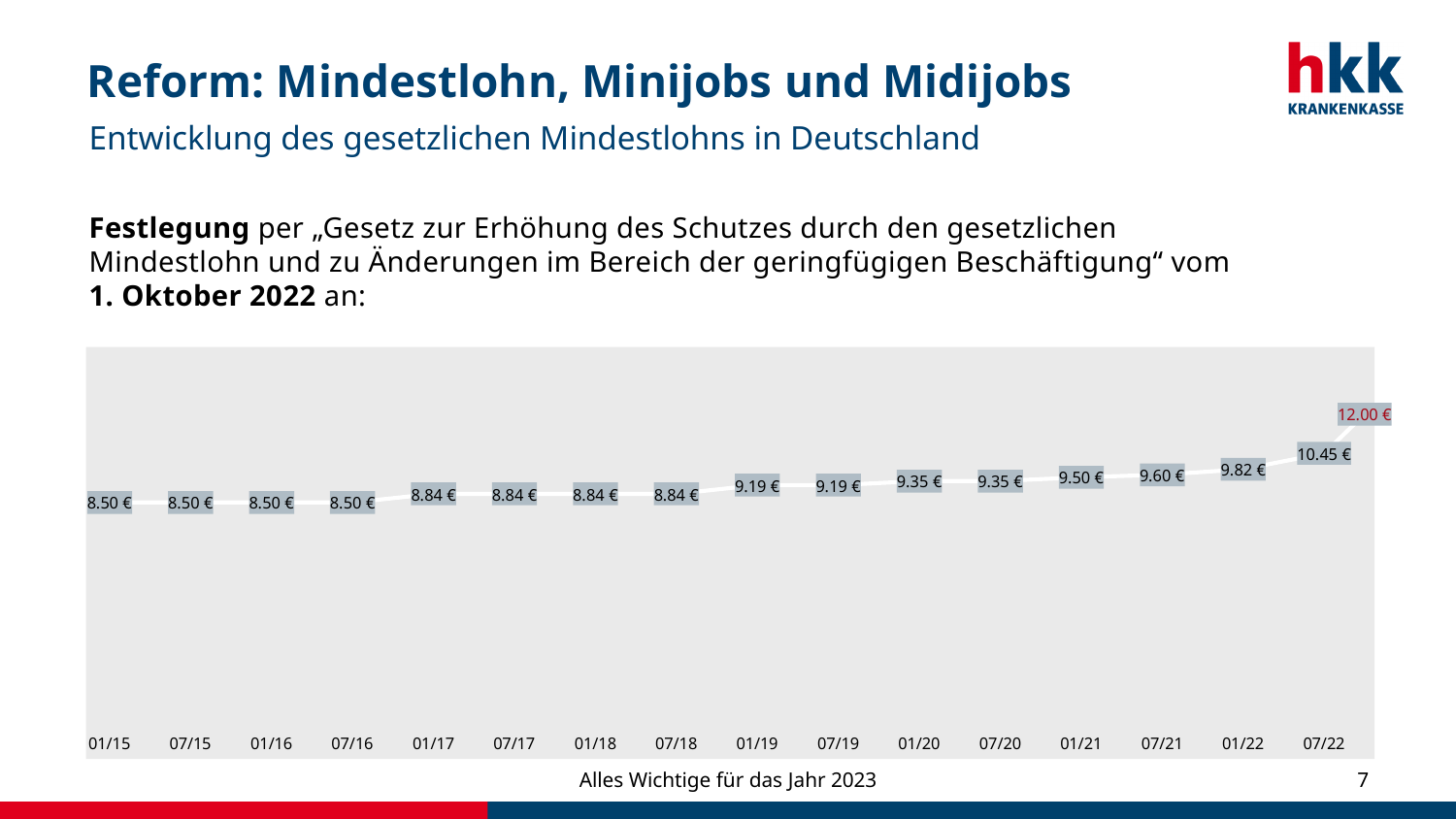
What is the highest value labelled on the chart? 12.00 € What type of chart is shown on the slide? line chart What is the difference between the values for 01/21 and 01/15? 1.00 € What is the difference between the values for 07/22 and 01/22? 0.63 € Which has the larger value, 07/21 or 01/20? 07/21 What is the value shown for 01/21? 9.50 € What is the value shown for 07/22? 10.45 € What is the lowest value labelled on the chart? 8.50 € Do the values rise or fall along the x axis from 01/15 onwards? rise What is the value shown for 01/15? 8.50 € What is the value shown for 01/17? 8.84 € What is the value shown for 01/19? 9.19 €